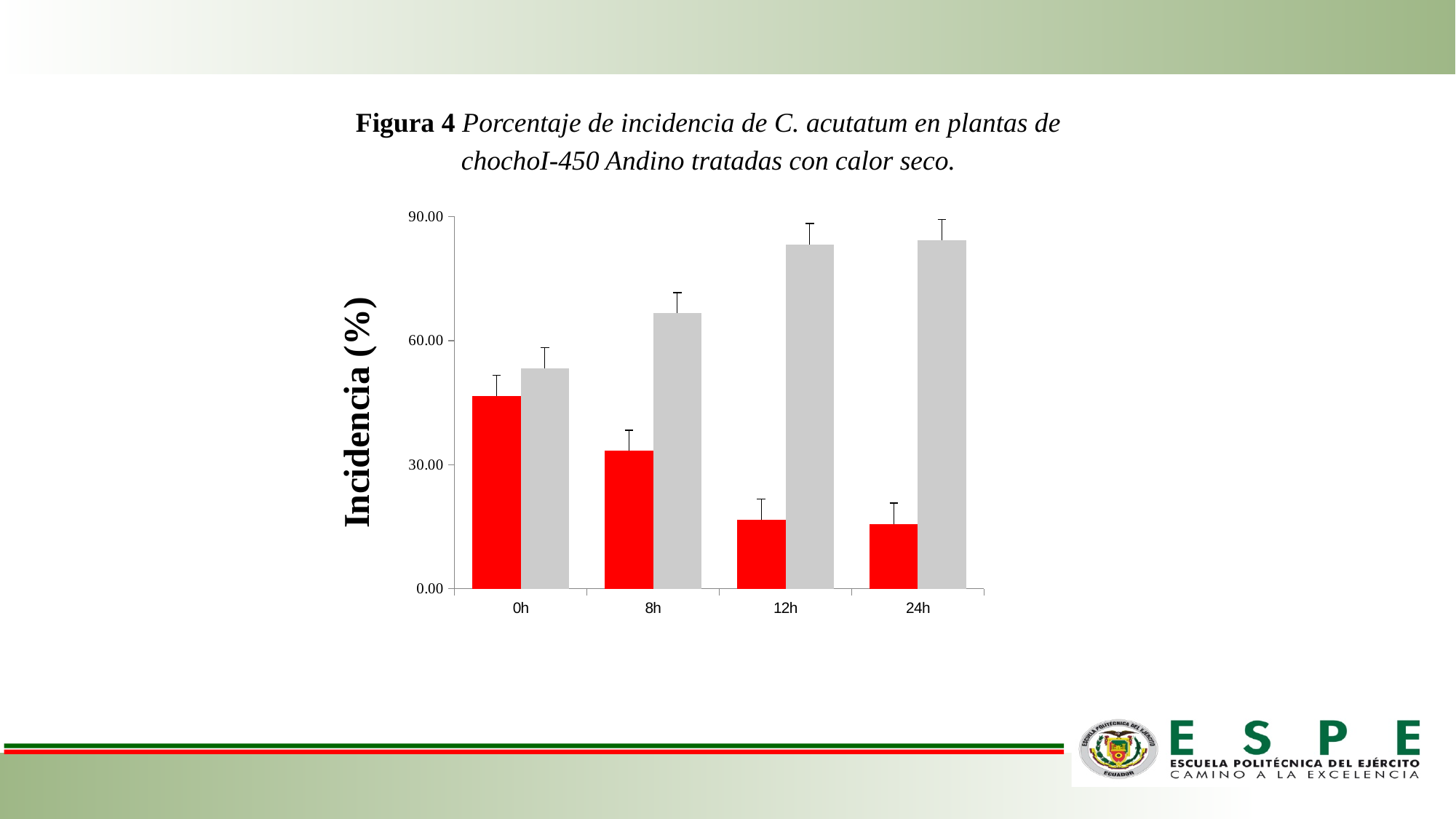
At which category is the red bar highest? 0h At which category is the grey bar lowest? 0h What is the label of the y axis of the chart? Incidencia (%) What kind of chart is shown on the slide? bar chart Do the red bars rise or fall from 0h to 24h? fall At 24h, which bar is larger, the red bar or the grey bar? the grey bar Do the grey bars rise or fall from 0h to 24h? rise Is the value of the red bar at 12h greater or less than 30.00? less How many categories are shown on the x axis of the chart? 4 Is the value of the grey bar at 12h greater or less than 60.00? greater What are the category labels along the x axis of the chart? 0h, 8h, 12h, 24h Is the value of the red bar at 0h greater or less than 30.00? greater